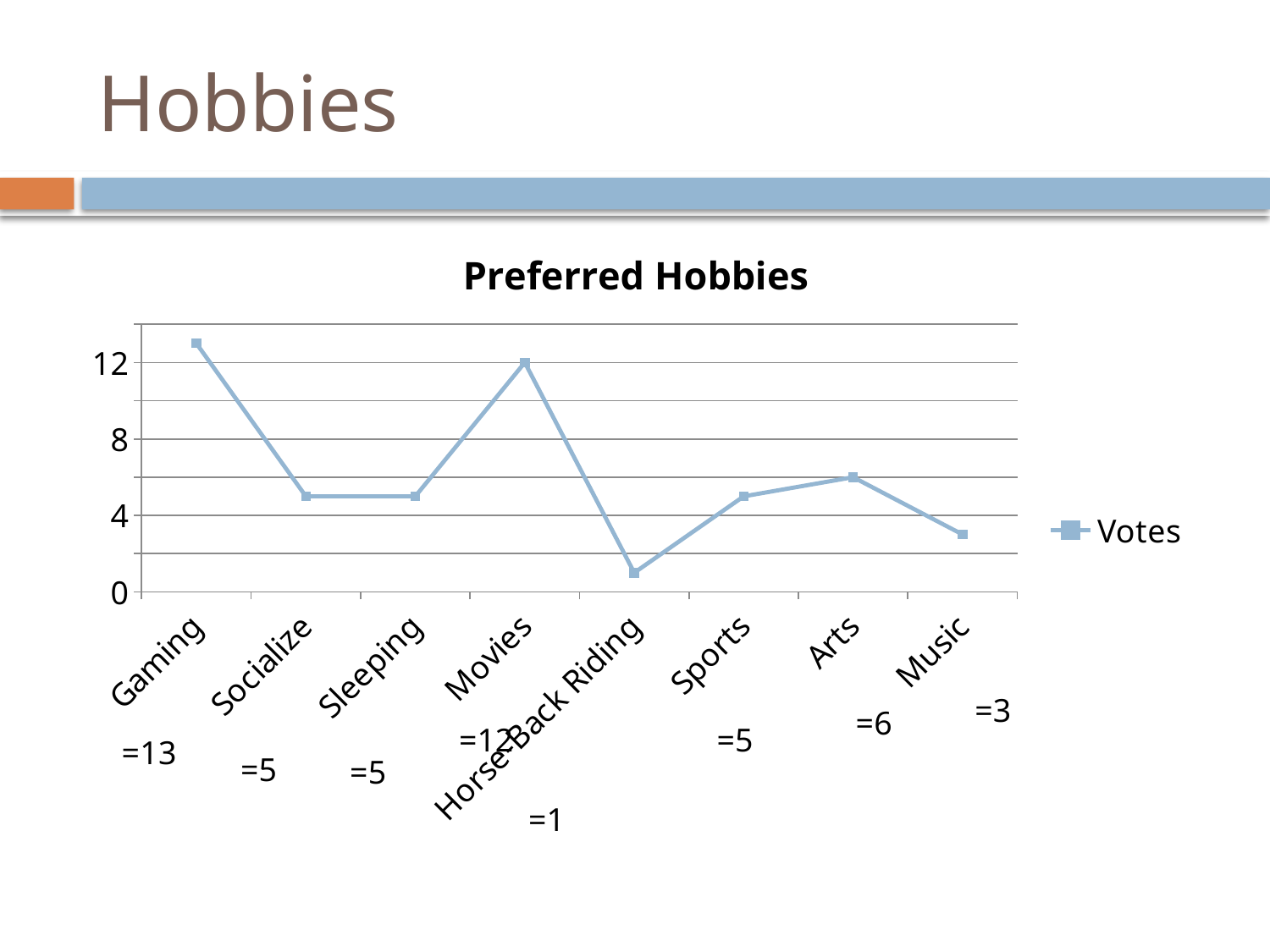
Which has more votes, Arts or Sports? Arts How many votes did Horse Back Riding receive? 1 How many hobby categories are plotted on the x axis? 8 How many votes did Gaming receive? 13 How many votes did Arts receive? 6 Is the value for Movies greater or less than 8? greater How many series does the legend list? 1 Which hobby has the lowest number of votes? Horse Back Riding What is the difference in votes between Gaming and Music? 10 What type of chart is shown on the slide? line chart Which hobby has the highest number of votes? Gaming What is the title of the chart? Preferred Hobbies